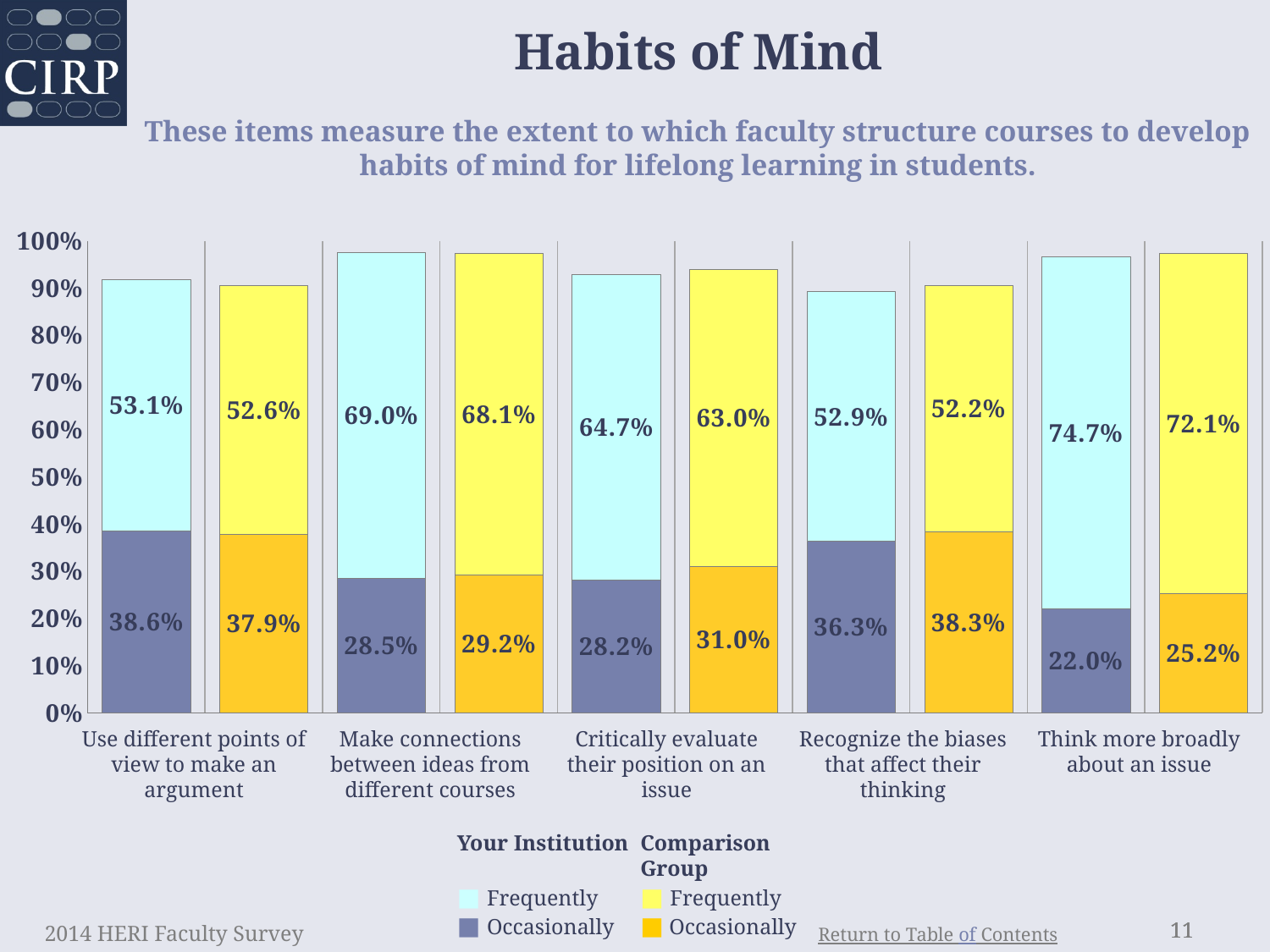
Which item has the highest 'Frequently' value for Your Institution? Think more broadly about an issue How many items (categories) are shown on the x axis of the chart? 5 What is the combined total of 'Frequently' and 'Occasionally' for the Comparison Group on 'Use different points of view to make an argument'? 90.5% What percentage of faculty at Your Institution report 'Frequently' for 'Think more broadly about an issue'? 74.7% What is the combined total of 'Frequently' and 'Occasionally' for Your Institution on 'Make connections between ideas from different courses'? 97.5% What is the difference between the Your Institution and Comparison Group 'Frequently' values for 'Think more broadly about an issue'? 2.6 percentage points How many series does the legend list? 4 What is the Comparison Group 'Occasionally' value for 'Recognize the biases that affect their thinking'? 38.3% What is the Your Institution 'Occasionally' value for 'Critically evaluate their position on an issue'? 28.2% Which item has the lowest 'Occasionally' value for the Comparison Group? Think more broadly about an issue For 'Critically evaluate their position on an issue', is the 'Occasionally' value larger for Your Institution or the Comparison Group? Comparison Group What kind of chart is shown on the slide? Stacked bar chart